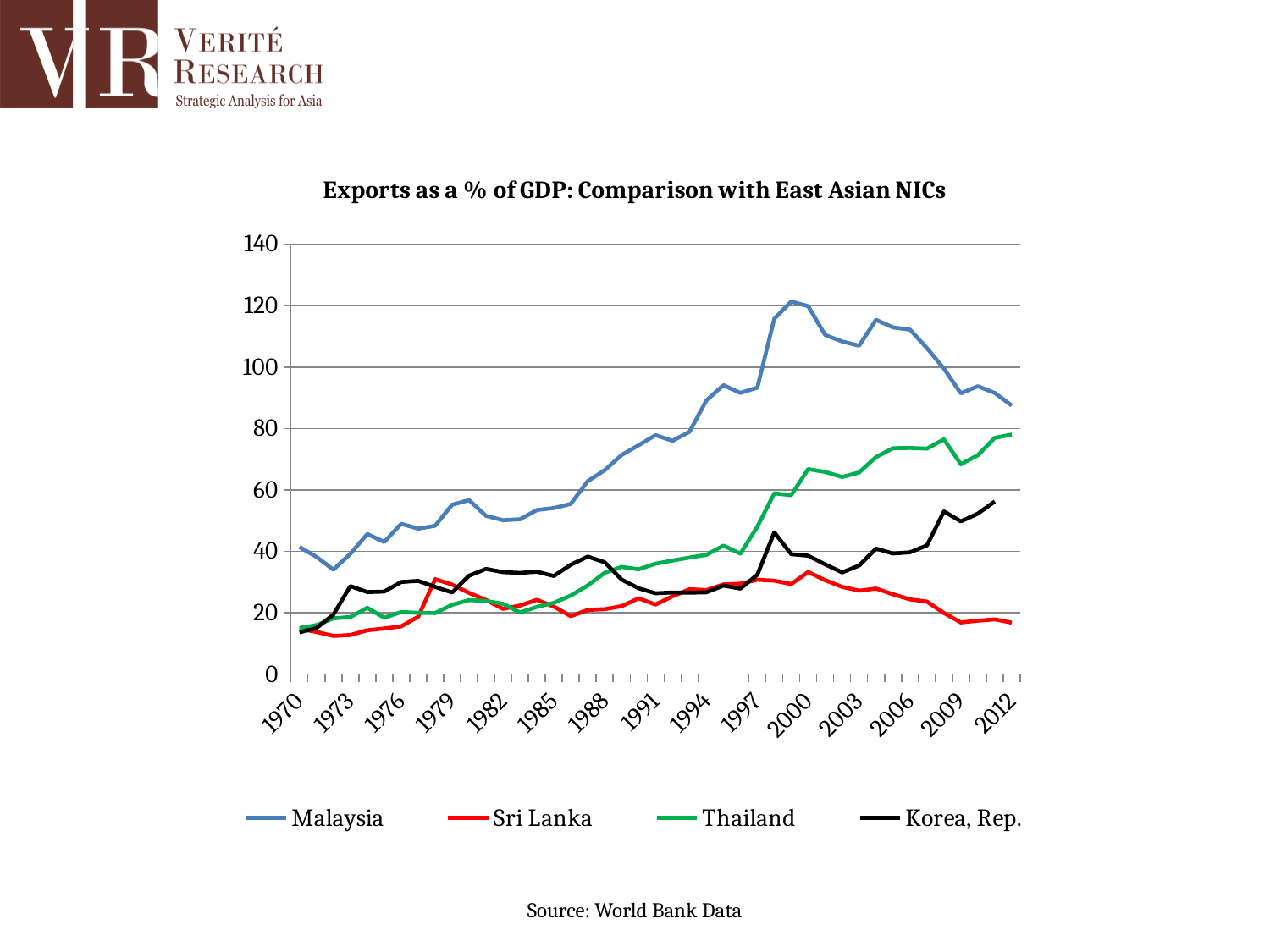
What is the title of the chart? Exports as a % of GDP: Comparison with East Asian NICs Which country has the highest exports as a % of GDP in 2000? Malaysia Is the value for Thailand in 2012 greater or less than 60? greater Does the Sri Lanka line rise or fall between 1997 and 2012? Fall Is the value for Malaysia in 2000 greater or less than 100? greater What kind of chart is shown on the slide? Line chart Does the Malaysia line generally rise or fall between 1970 and 2000? Rise Is the value for Sri Lanka in 2012 greater or less than 20? less How many series does the legend list? 4 Which country has the lowest exports as a % of GDP in 2012? Sri Lanka Which country is represented by the green line? Thailand